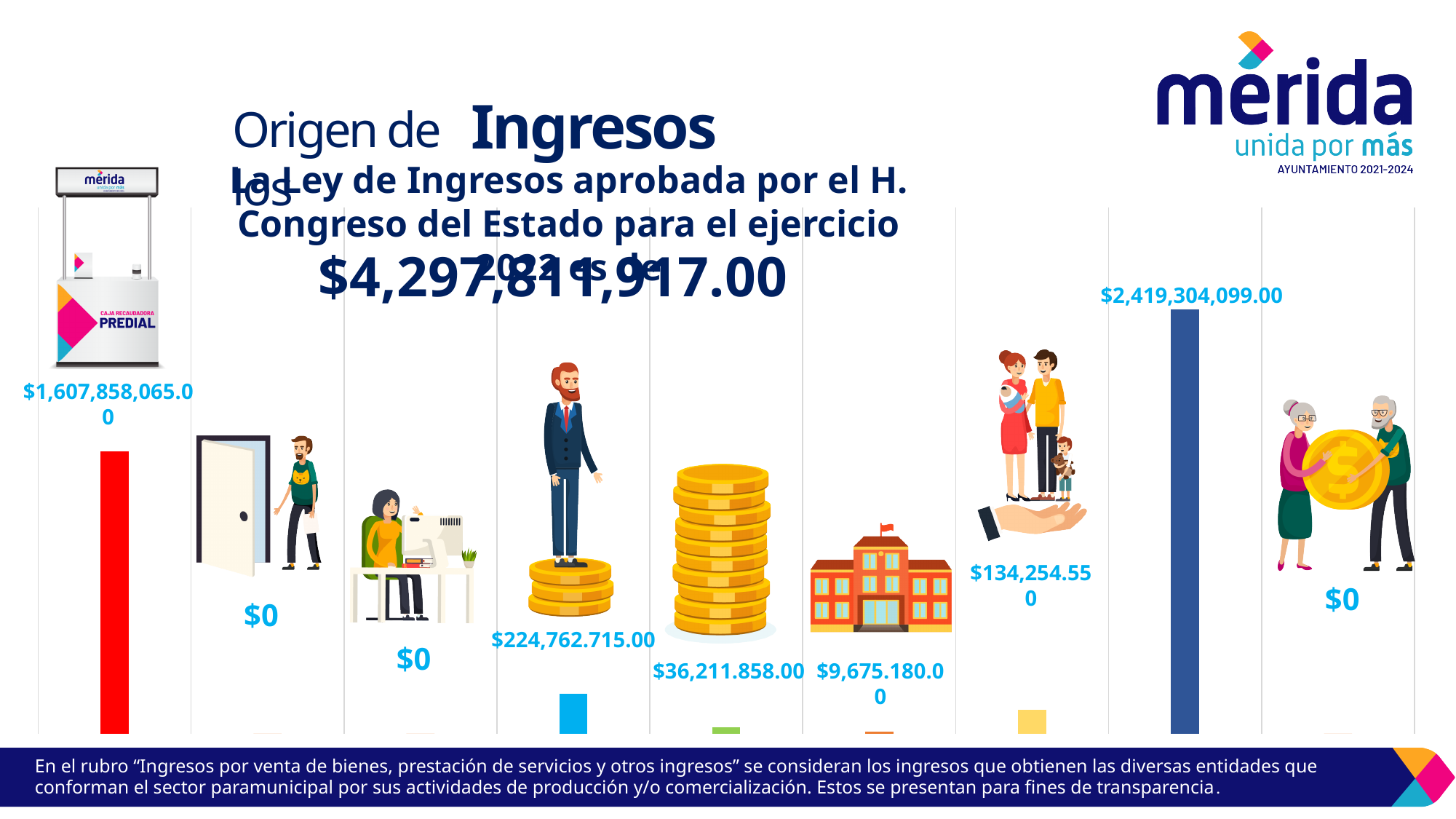
What is the value labelled on the green bar (fifth from the left)? $36,211.858.00 What is the difference between the dark blue bar ($2,419,304,099.00) and the red bar ($1,607,858,065.00)? $811,446,034.00 What is the value labelled on the yellow bar (seventh from the left)? $134,254.550 Which is larger: the value of the red bar at the far left or the value of the dark blue bar near the right? the dark blue bar What is the value labelled on the light blue bar in the middle of the chart (fourth from the left)? $224,762.715.00 What total amount for the Ley de Ingresos is stated in the chart's heading text? $4,297,811,917.00 How many bars in the chart are labelled $0? 3 How many bars (categories) does the chart contain? 9 What is the value labelled on the tallest bar (the dark blue bar near the right)? $2,419,304,099.00 What kind of chart is shown on the slide? bar chart What is the value labelled on the red bar at the far left of the chart? $1,607,858,065.00 What is the value labelled on the orange bar (sixth from the left)? $9,675.180.00